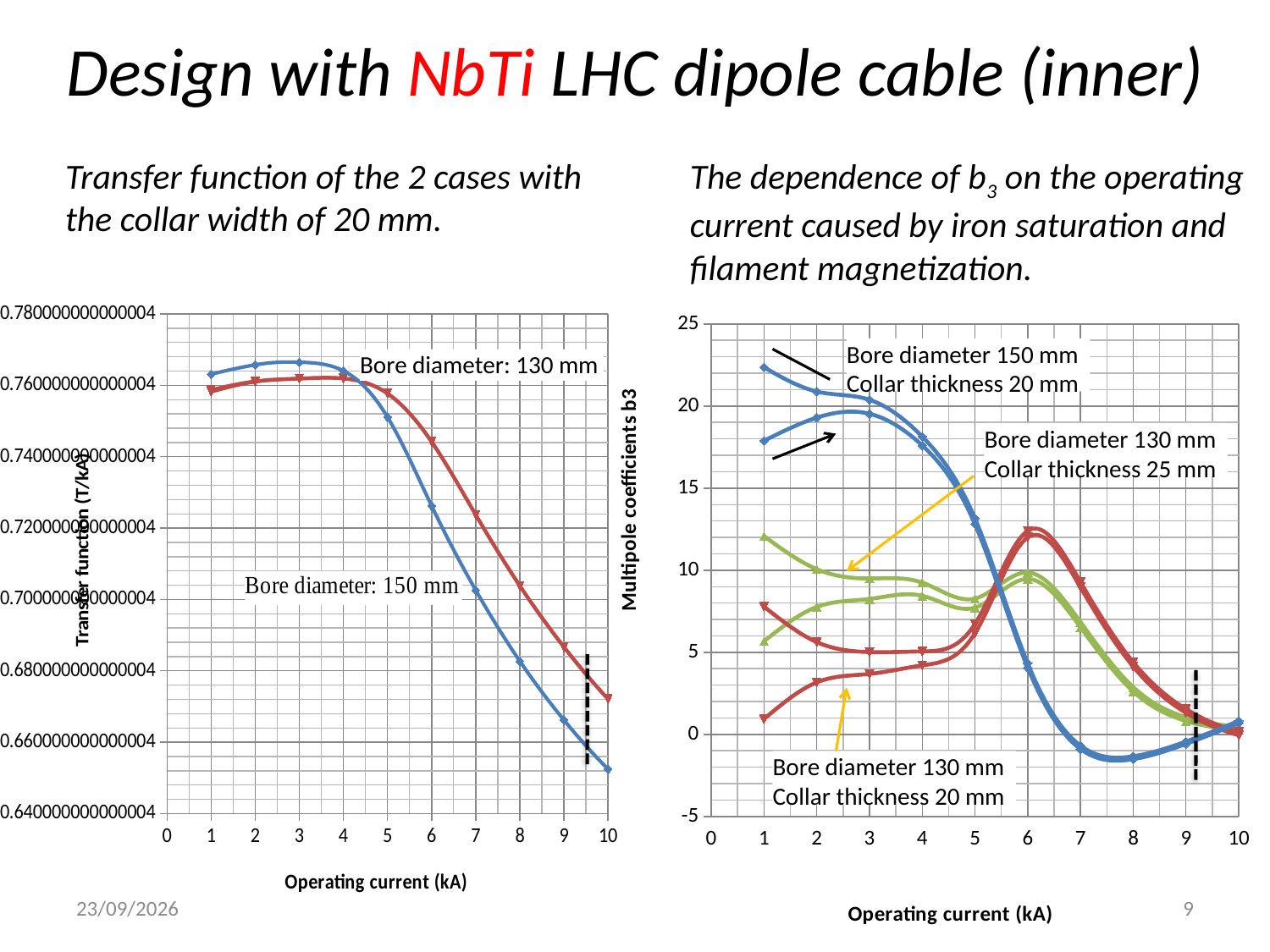
On the left chart, is the transfer function for Bore diameter 150 mm at 10 kA greater or less than 0.66? less On the left chart, what is the x-axis title? Operating current (kA) On the right chart, is the peak of the red curve at 6 kA greater or less than 10? greater What type of chart is the right chart (Multipole coefficients b3)? line chart How many curves are plotted on the right chart? 6 What type of chart is the left chart (Transfer function)? line chart On the left chart, is the transfer function for Bore diameter 130 mm at 10 kA greater or less than 0.66? greater How many series are plotted on the left chart? 2 On the left chart, which series has the higher transfer function at 10 kA, Bore diameter 130 mm or Bore diameter 150 mm? Bore diameter 130 mm On the left chart, do the transfer function values rise or fall between 5 kA and 10 kA? fall On the right chart, what is the y-axis title? Multipole coefficients b3